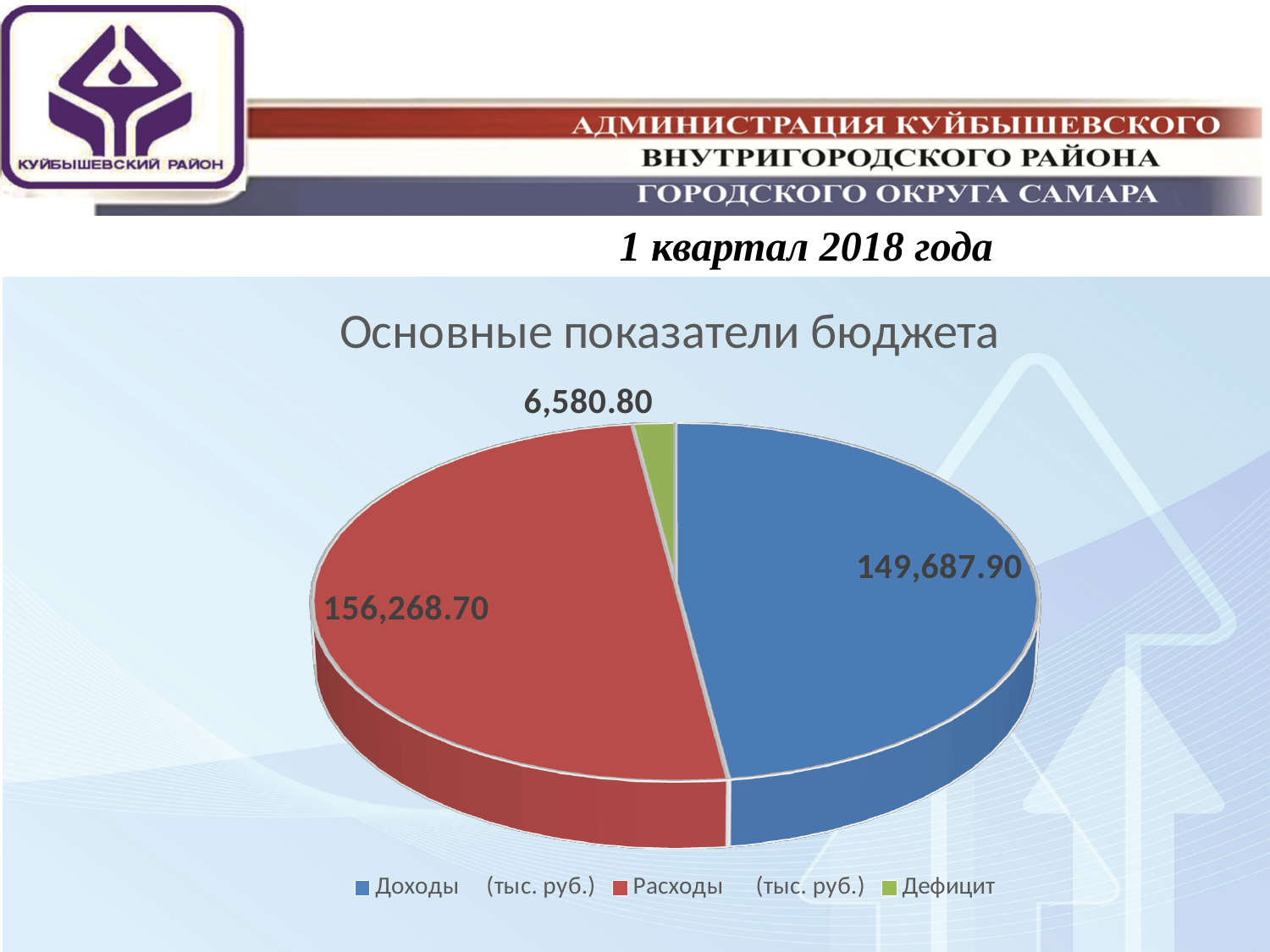
What is the value for Расходы (тыс. руб.)? 156,268.70 What share of the pie does Расходы represent? 50% What is the value for Доходы (тыс. руб.)? 149,687.90 What is the title of the chart? Основные показатели бюджета How many entries does the legend list? 3 How many slices does the pie chart have? 3 Which category has the largest slice of the pie? Расходы (тыс. руб.) Which category has the smallest slice of the pie? Дефицит What is the difference between Расходы and Доходы? 6,580.80 Which is larger, Доходы or Расходы? Расходы What is the value for Дефицит? 6,580.80 What type of chart is shown on the slide? Pie chart